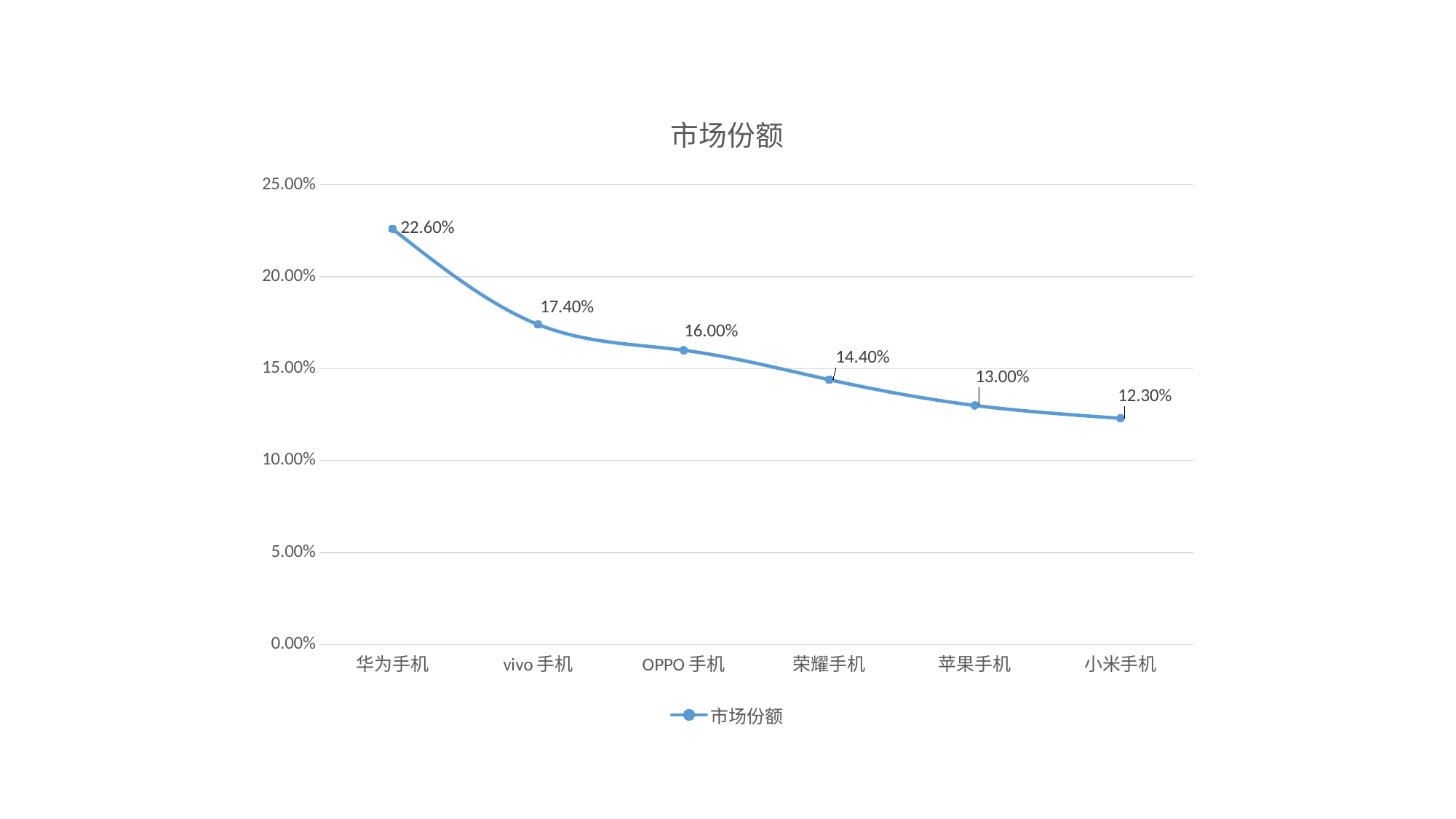
What kind of chart is shown on the slide? Line chart What is the market share value for 荣耀手机? 14.40% Which has a larger market share, vivo 手机 or 苹果手机? vivo 手机 What is the difference between the market share of OPPO 手机 and 苹果手机? 3.00% How many categories are plotted on the x axis? 6 Which category has the lowest market share? 小米手机 What is the difference between the market share of 华为手机 and vivo 手机? 5.20% Do the values rise or fall from left to right along the x axis? Fall How many series does the legend list? 1 What is the market share value for 华为手机? 22.60% What is the market share value for 小米手机? 12.30% Which category has the highest market share? 华为手机